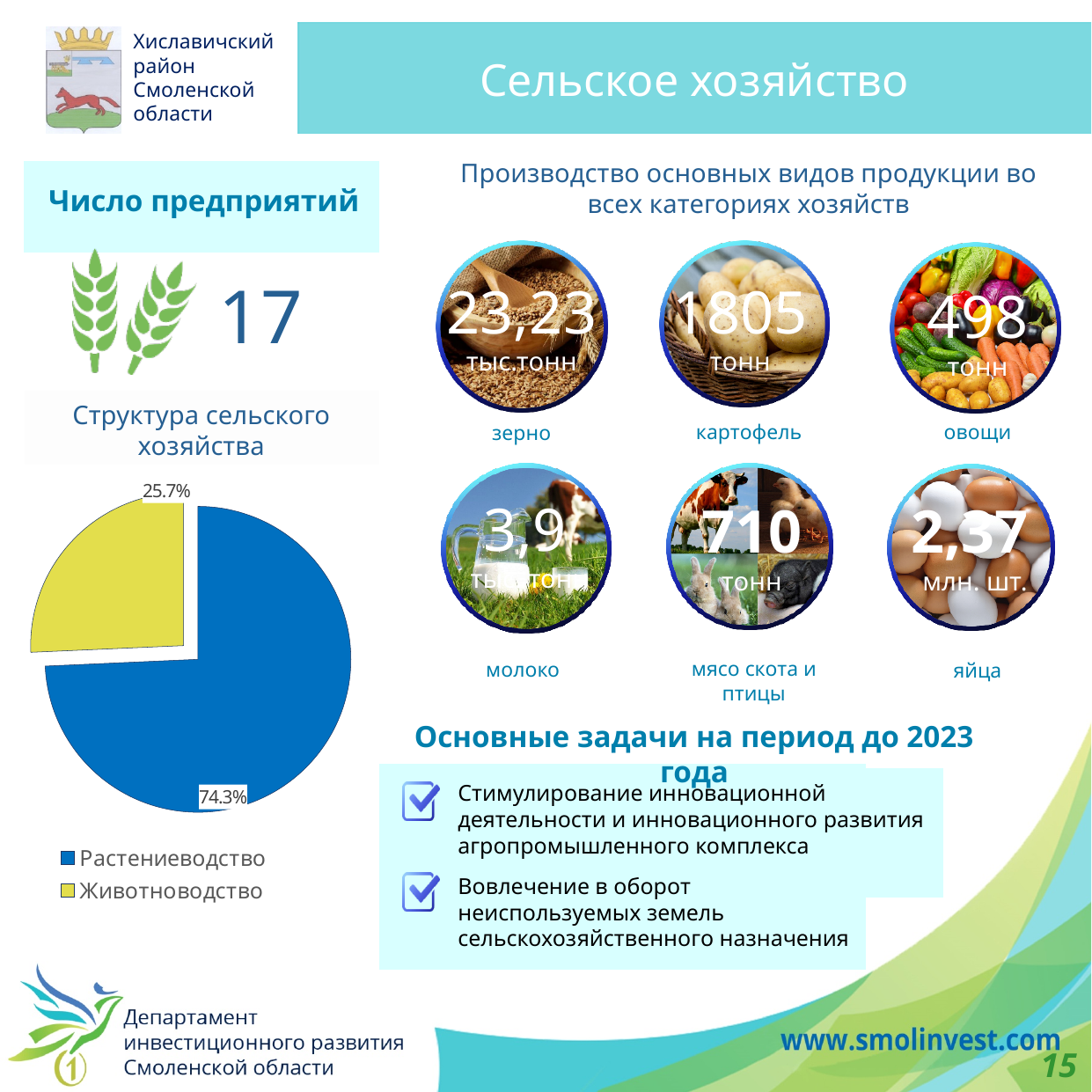
In the pie chart «Структура сельского хозяйства», what share does Растениеводство have? 74.3% In the pie chart «Структура сельского хозяйства», which is larger: Растениеводство or Животноводство? Растениеводство In the pie chart «Структура сельского хозяйства», what share does Животноводство have? 25.7% In the pie chart «Структура сельского хозяйства», what colour is the Животноводство slice? yellow In the pie chart «Структура сельского хозяйства», which category has the largest share? Растениеводство In the pie chart «Структура сельского хозяйства», what colour is the Растениеводство slice? blue In the pie chart «Структура сельского хозяйства», what is the difference in percentage points between Растениеводство and Животноводство? 48.6 In the pie chart «Структура сельского хозяйства», is the share of Животноводство greater or less than 50%? less In the pie chart «Структура сельского хозяйства», which category has the smallest share? Животноводство How many entries does the legend of the pie chart «Структура сельского хозяйства» list? 2 How many slices does the pie chart «Структура сельского хозяйства» have? 2 What kind of chart is shown under the heading «Структура сельского хозяйства»? pie chart